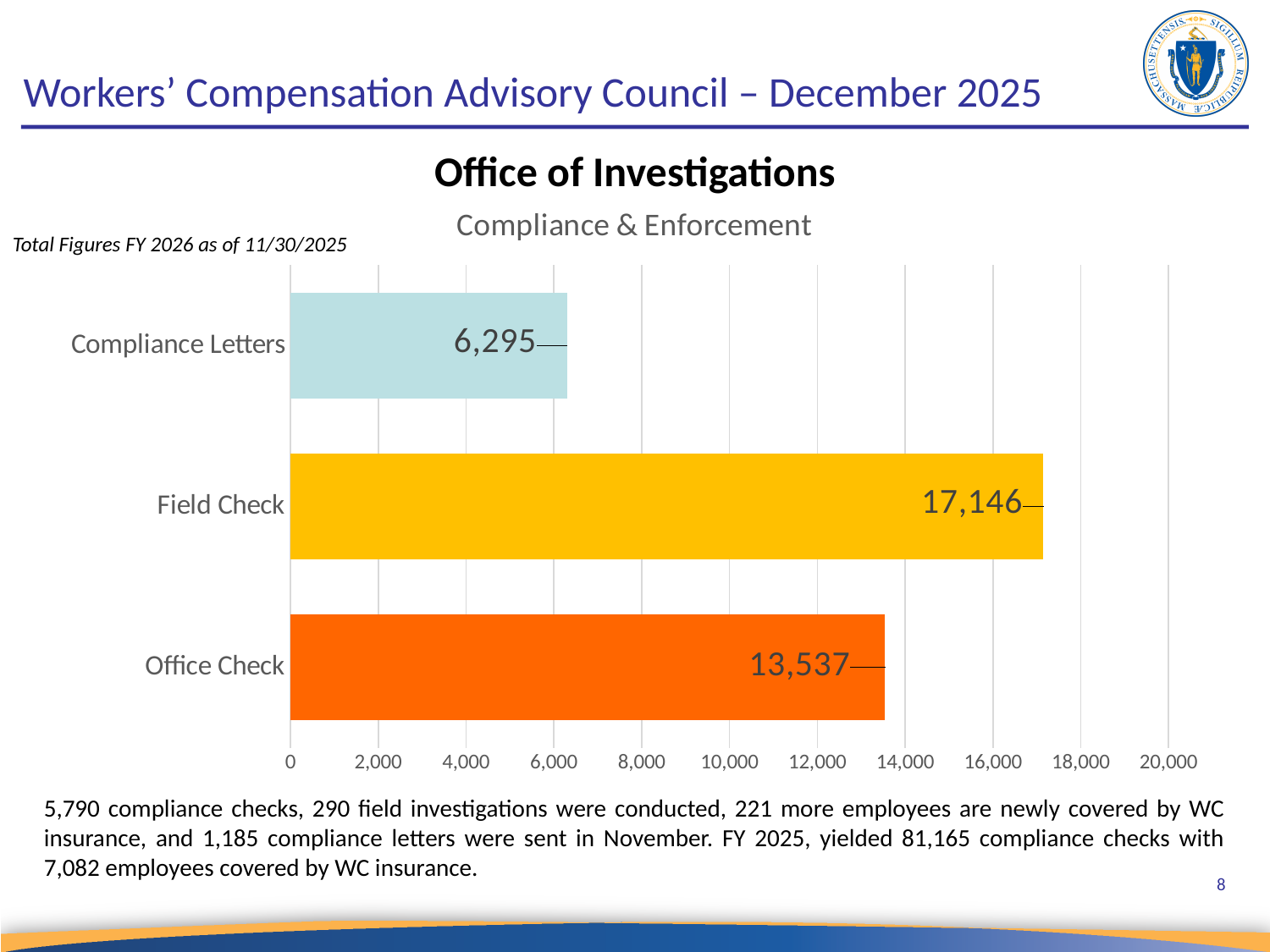
What is the title of the chart? Compliance & Enforcement What is the value for Field Check? 17,146 Which is larger, the value for Office Check or the value for Compliance Letters? Office Check Which category has the lowest value? Compliance Letters How many categories are shown in the chart? 3 Is the value for Field Check greater or less than 16,000? greater Which category has the highest value? Field Check What is the difference between the Office Check and Compliance Letters values? 7,242 What is the difference between the Field Check and Office Check values? 3,609 What is the value for Office Check? 13,537 What is the value for Compliance Letters? 6,295 What kind of chart is shown on the slide? Bar chart